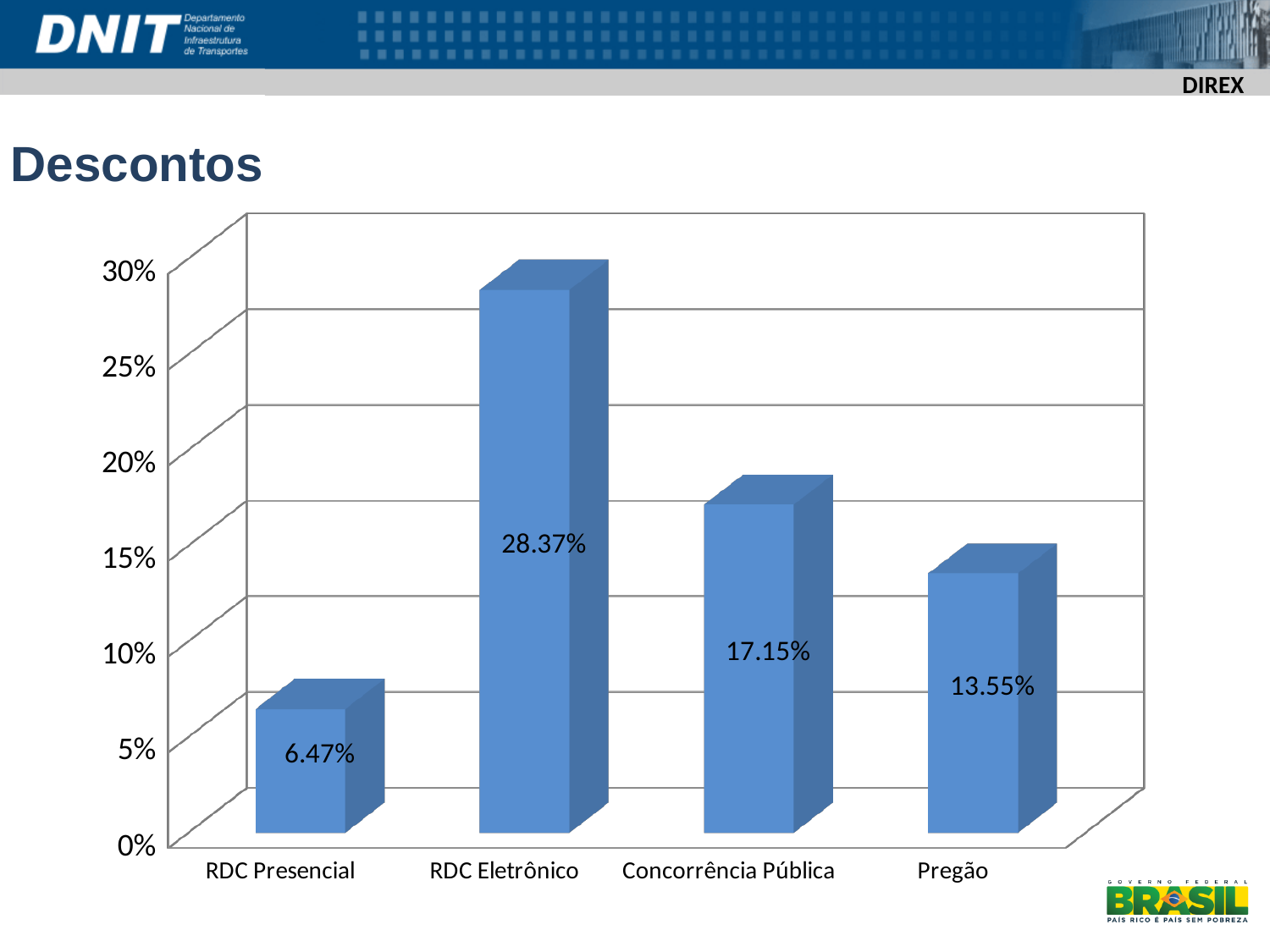
What is the value for Concorrência Pública? 17.15% Which is larger, the value for Concorrência Pública or the value for Pregão? Concorrência Pública What is the value for Pregão? 13.55% What is the value for RDC Presencial? 6.47% Which category has the highest value? RDC Eletrônico What is the title of the slide containing the chart? Descontos What kind of chart is shown on the slide? Bar chart Which category has the lowest value? RDC Presencial What is the value for RDC Eletrônico? 28.37% What is the difference between the values for Concorrência Pública and Pregão? 3.60% How many categories are shown on the chart? 4 What is the difference between the values for RDC Eletrônico and RDC Presencial? 21.90%